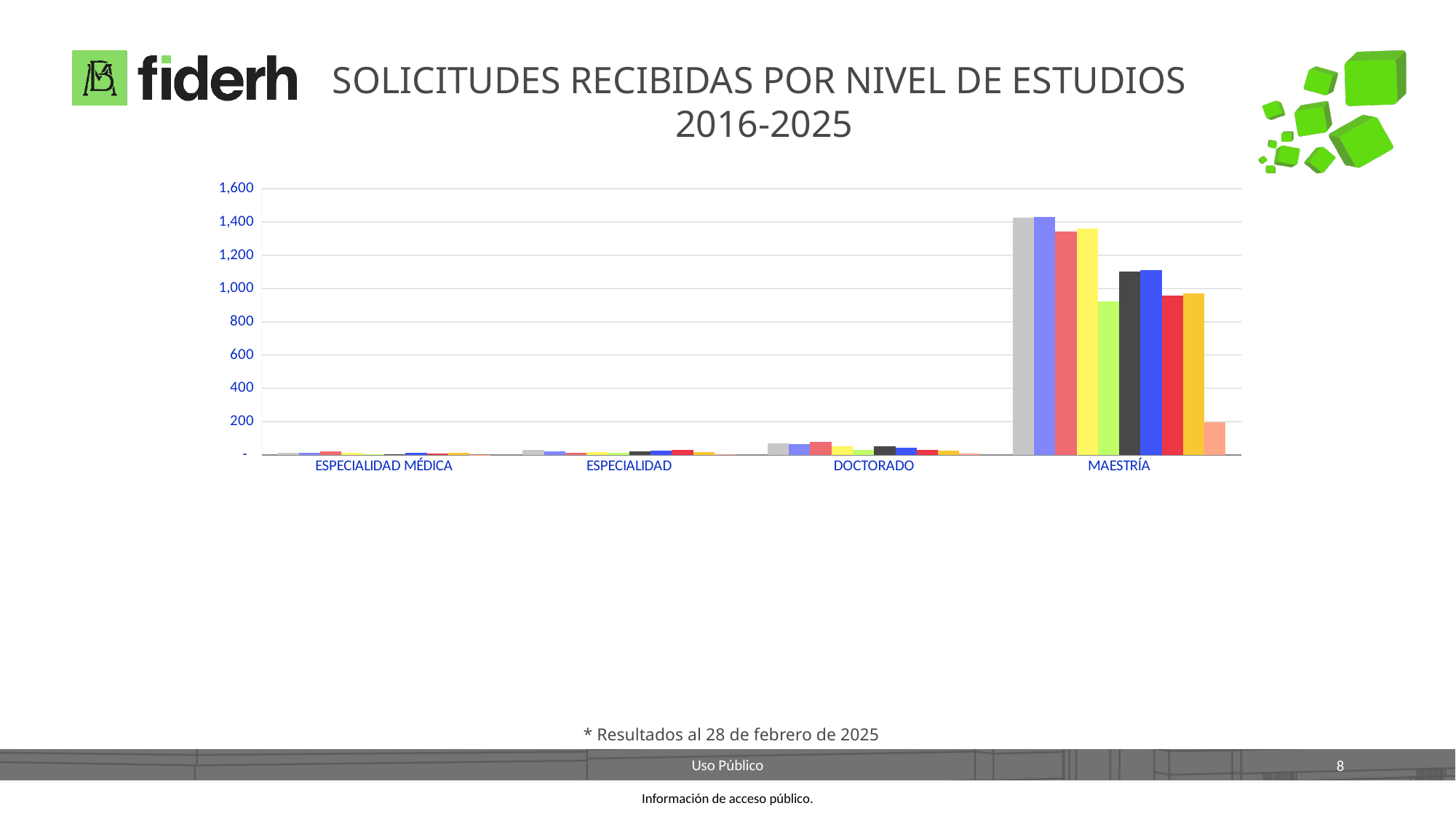
How many study-level categories are shown on the x axis? 4 What is the highest value shown on the vertical axis? 1,600 Are all the bars in the DOCTORADO group greater or less than 200? less What kind of chart is shown on the slide? bar chart Which category has taller bars, DOCTORADO or ESPECIALIDAD MÉDICA? DOCTORADO Is the tallest bar in the MAESTRÍA group greater or less than 1,200? greater Which category has the highest bars? MAESTRÍA How many bars are in the MAESTRÍA group? 10 Is the last (rightmost) bar in the MAESTRÍA group greater or less than 400? less Which category has taller bars, MAESTRÍA or DOCTORADO? MAESTRÍA What is the title of the chart on the slide? SOLICITUDES RECIBIDAS POR NIVEL DE ESTUDIOS 2016-2025